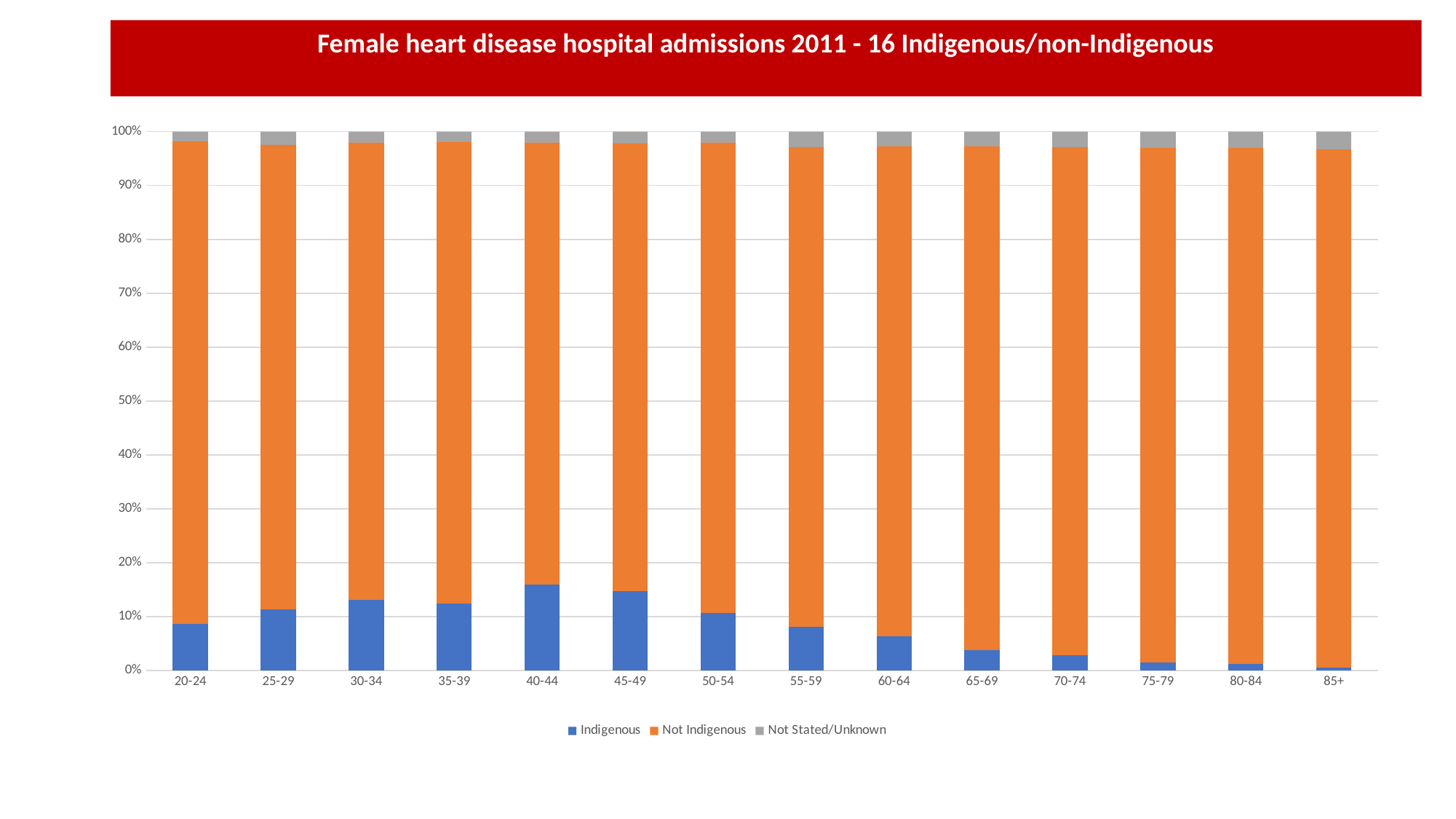
Is the Indigenous value for 40-44 greater or less than 10%? greater How many series does the legend list? 3 Which series is shown in orange? Not Indigenous What kind of chart is shown on the slide? Stacked bar chart From 45-49 to 85+, does the Indigenous share rise or fall along the x axis? fall What is the title of the chart? Female heart disease hospital admissions 2011 - 16 Indigenous/non-Indigenous Which is larger, the Indigenous share for 30-34 or for 60-64? 30-34 Which age group has the lowest Indigenous share? 85+ Is the Indigenous value for 65-69 greater or less than 10%? less Which is larger, the Indigenous share for 25-29 or for 70-74? 25-29 How many age-group categories are shown on the x axis? 14